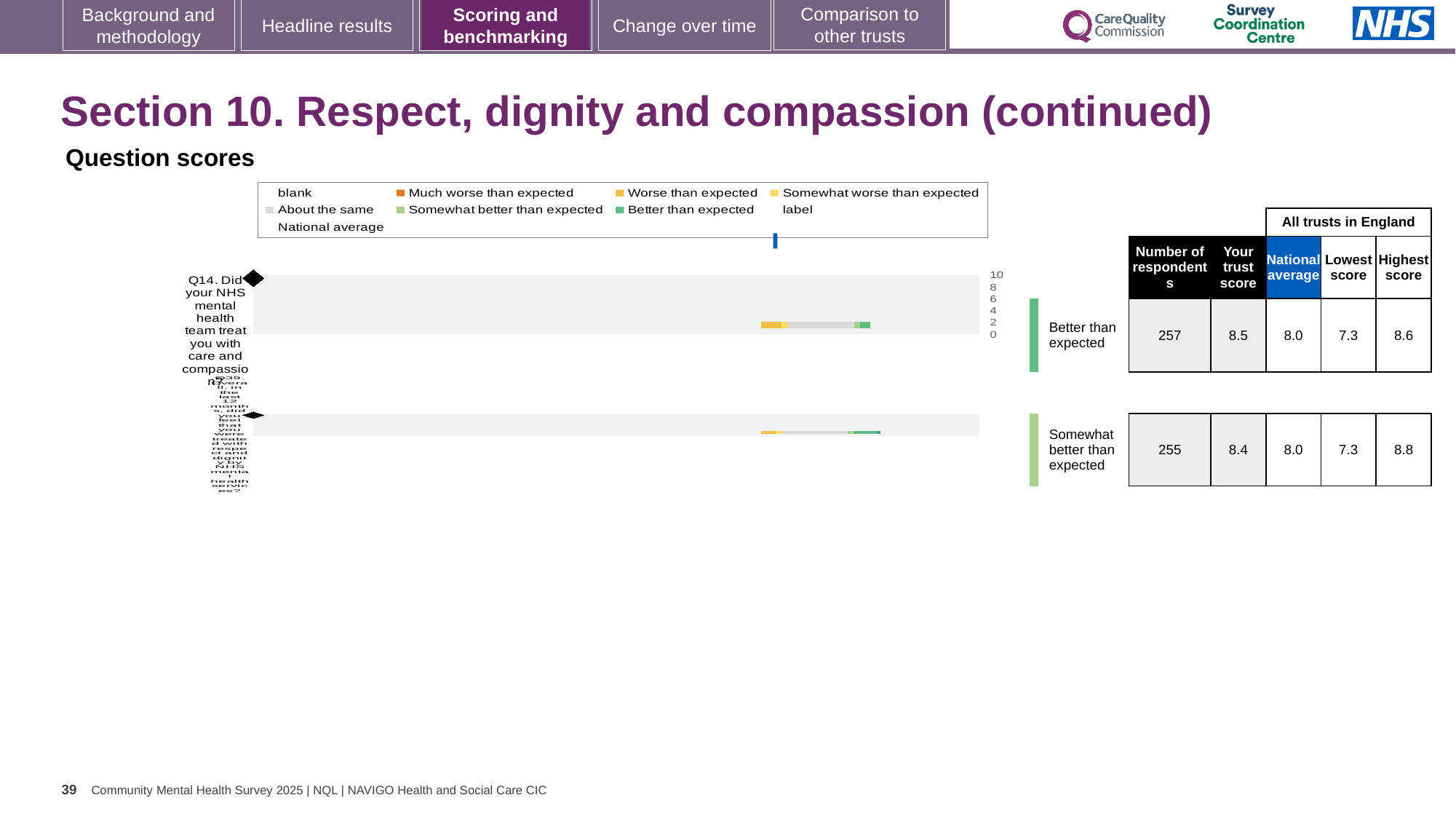
What is your trust score for Q14 (treated with care and compassion)? 8.5 Which question has the higher trust score, Q14 or Q39? Q14 What rating category is shown for Q14 in the question scores chart? Better than expected What is the number of respondents for Q14 (treated with care and compassion)? 257 What is the number of respondents for Q39 (treated with respect and dignity)? 255 By how much does your trust score for Q14 exceed the national average for Q14? 0.5 What is the lowest score among all trusts in England for Q39? 7.3 What is the national average score for Q14? 8.0 What kind of chart is used to show the question scores on this slide? bar chart What is the highest score among all trusts in England for Q39 (treated with respect and dignity)? 8.8 What rating category is shown for Q39 in the question scores chart? Somewhat better than expected How many questions are plotted in the question scores chart? 2